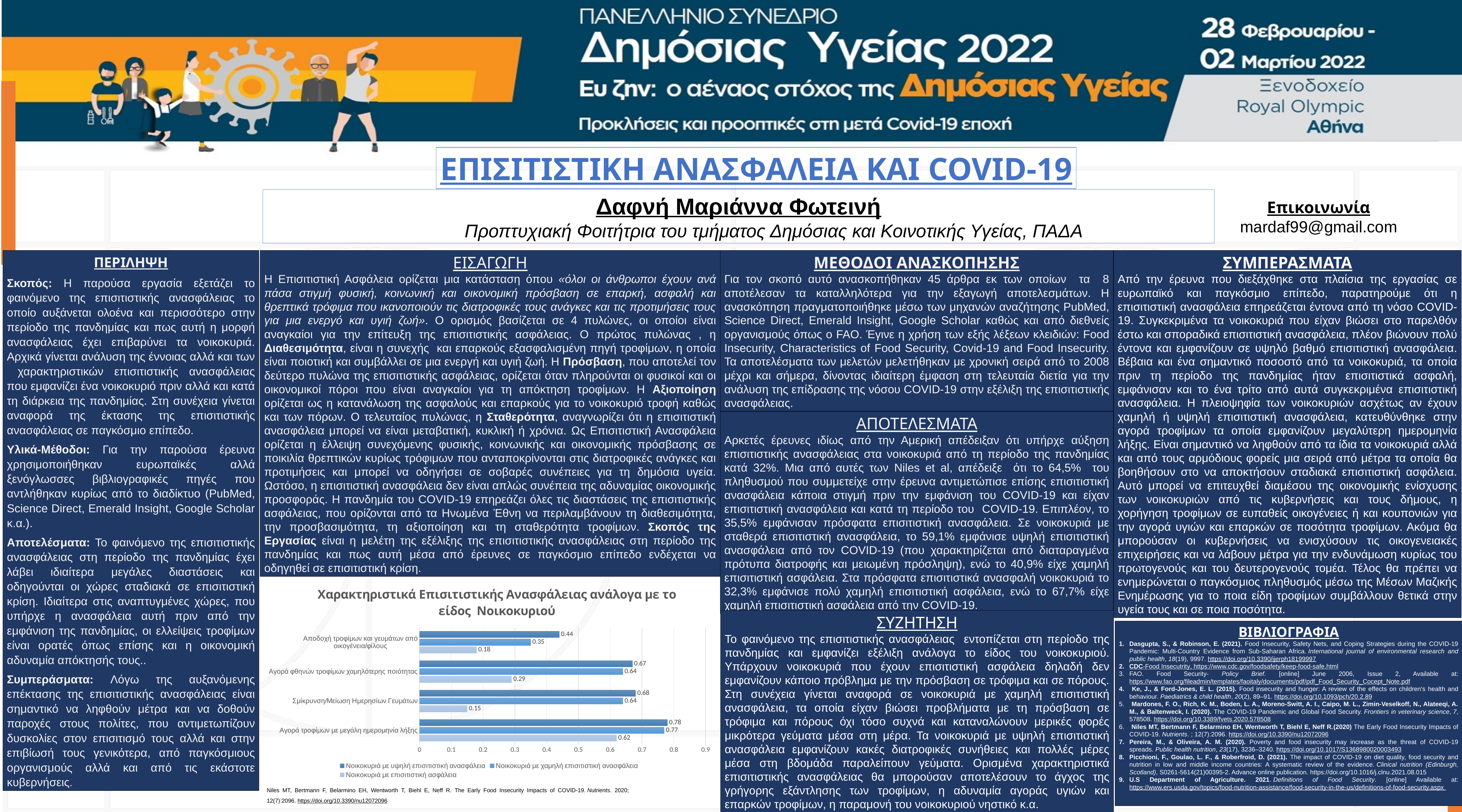
Which category has the lowest value for 'Νοικοκυριά με υψηλή επισιτιστική ανασφάλεια'? Αποδοχή τροφίμων και γευμάτων από οικογένεια/φίλους What type of chart is shown on the slide? bar chart What is the difference between the 'Νοικοκυριά με υψηλή επισιτιστική ανασφάλεια' and 'Νοικοκυριά με επισιτιστική ασφάλεια' values in the category 'Αγορά φθηνών τροφίμων χαμηλότερης ποιότητας'? 0.38 What is the value for 'Νοικοκυριά με υψηλή επισιτιστική ανασφάλεια' in the category 'Αγορά τροφίμων με μεγάλη ημερομηνία λήξης'? 0.78 Is the value for 'Νοικοκυριά με επισιτιστική ασφάλεια' in the category 'Αγορά τροφίμων με μεγάλη ημερομηνία λήξης' greater or less than 0.5? greater How many series does the chart legend list? 3 What is the value for 'Νοικοκυριά με χαμηλή επισιτιστική ανασφάλεια' in the category 'Αποδοχή τροφίμων και γευμάτων από οικογένεια/φίλους'? 0.35 How many categories are shown on the chart? 4 In the category 'Σμίκρυνση/Μείωση Ημερησίων Γευμάτων', which is larger: the value for 'Νοικοκυριά με υψηλή επισιτιστική ανασφάλεια' or for 'Νοικοκυριά με επισιτιστική ασφάλεια'? Νοικοκυριά με υψηλή επισιτιστική ανασφάλεια What is the value for 'Νοικοκυριά με επισιτιστική ασφάλεια' in the category 'Σμίκρυνση/Μείωση Ημερησίων Γευμάτων'? 0.15 Which category has the highest value for 'Νοικοκυριά με επισιτιστική ασφάλεια'? Αγορά τροφίμων με μεγάλη ημερομηνία λήξης What is the title of the chart? Χαρακτηριστικά Επισιτιστικής Ανασφάλειας ανάλογα με το είδος Νοικοκυριού